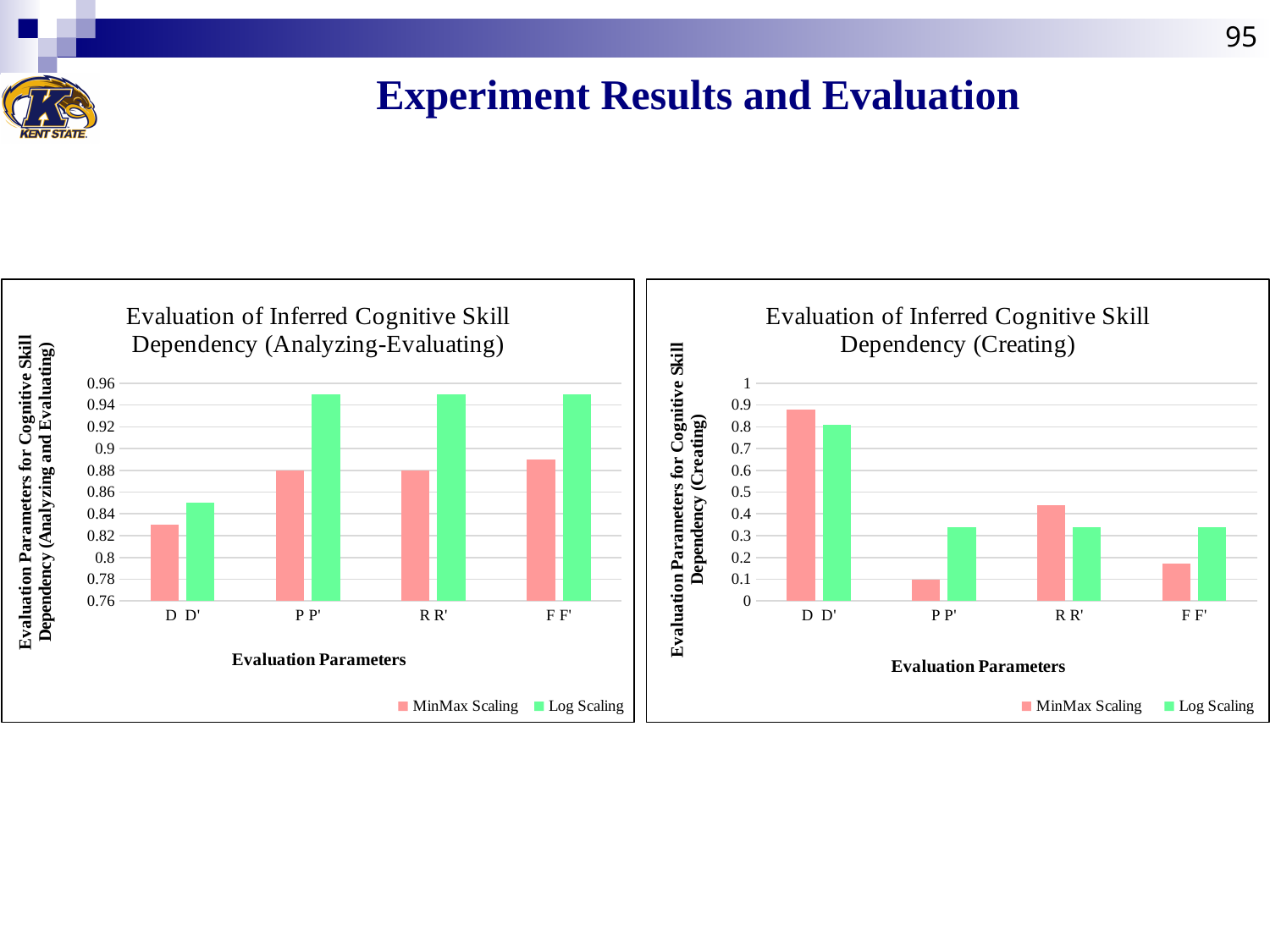
How many series does the legend of the right chart (Creating) list? 2 How many categories are shown on the x axis of the left chart (Analyzing-Evaluating)? 4 On the right chart (Creating), which category has the lowest MinMax Scaling value? P P' On the chart titled 'Evaluation of Inferred Cognitive Skill Dependency (Analyzing-Evaluating)', what is the MinMax Scaling value for P P'? 0.88 On the left chart (Analyzing-Evaluating), is the Log Scaling value for P P' greater or less than 0.94? greater On the chart titled 'Evaluation of Inferred Cognitive Skill Dependency (Creating)', what is the MinMax Scaling value for P P'? 0.1 On the left chart (Analyzing-Evaluating), is the MinMax Scaling value for D D' greater or less than 0.84? less On the right chart (Creating), is the MinMax Scaling value for F F' greater or less than 0.2? less On the right chart (Creating), for R R', which is larger: MinMax Scaling or Log Scaling? MinMax Scaling On the left chart (Analyzing-Evaluating), which category has the lowest MinMax Scaling value? D D' On the right chart (Creating), which category has the highest MinMax Scaling value? D D'